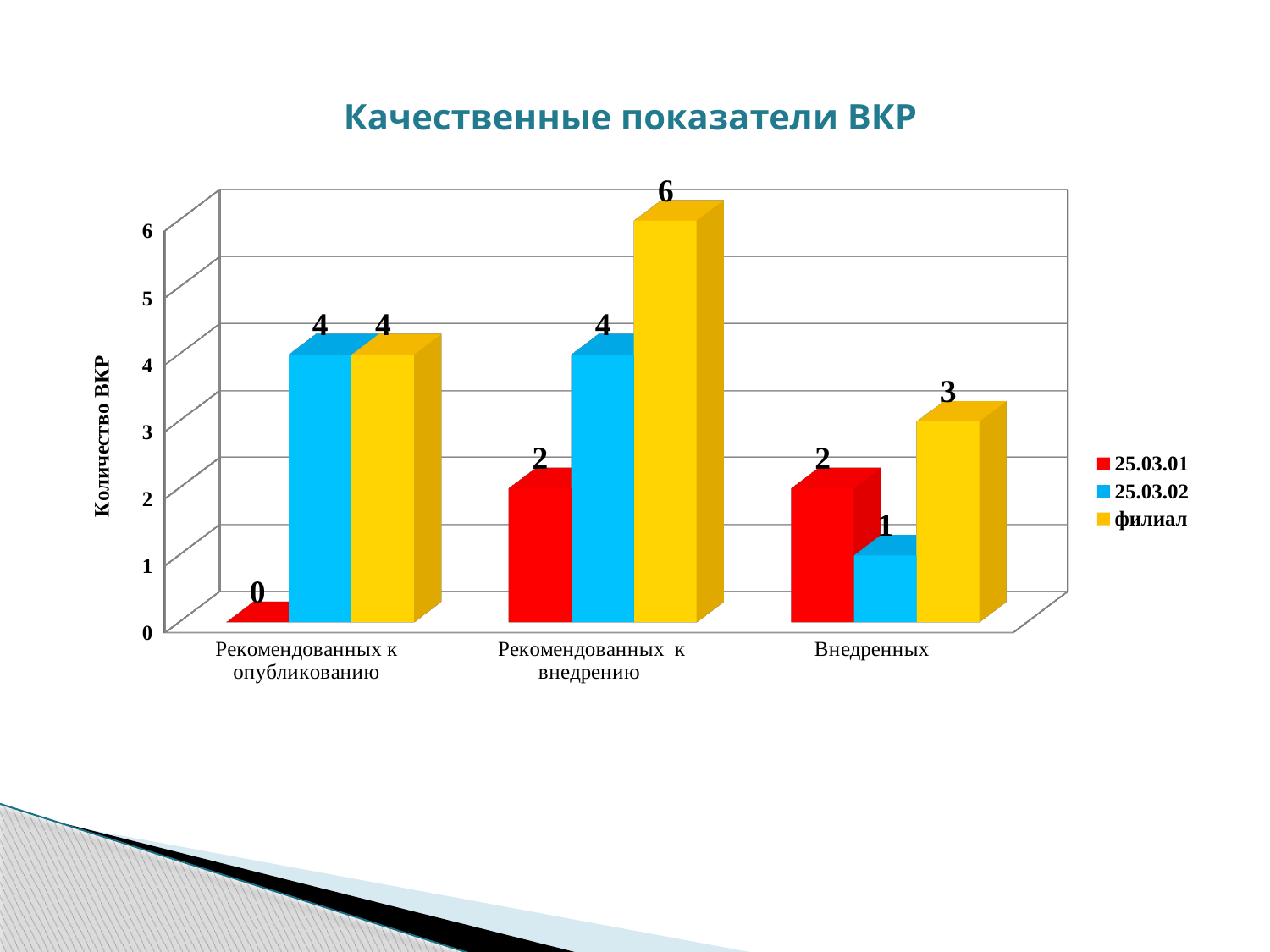
What is the difference between the филиал value and the 25.03.01 value in the category "Рекомендованных к внедрению"? 4 In which category does the 25.03.02 series have its lowest value? Внедренных In the category "Внедренных", which series has the larger value: 25.03.01 or 25.03.02? 25.03.01 What is the value for 25.03.01 in the category "Внедренных"? 2 What kind of chart is shown on the slide? Bar chart What is the value for 25.03.02 in the category "Внедренных"? 1 How many series does the legend list? 3 What is the value for филиал in the category "Рекомендованных к внедрению"? 6 What is the value for 25.03.01 in the category "Рекомендованных к опубликованию"? 0 How many categories are shown on the x axis? 3 In which category does the филиал series have its highest value? Рекомендованных к внедрению What is the title of the chart? Качественные показатели ВКР